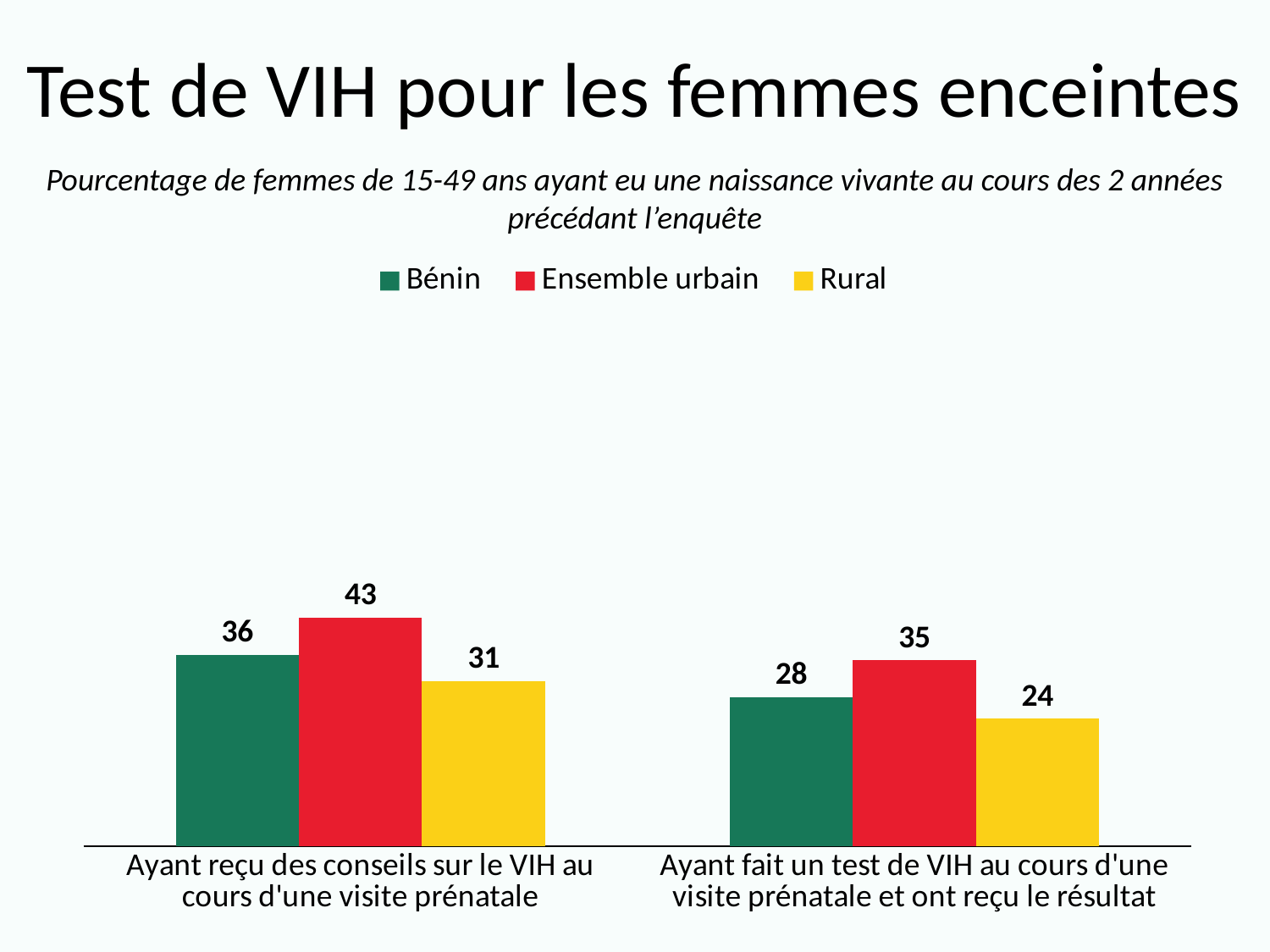
Which is larger: the Rural value for 'Ayant reçu des conseils sur le VIH' or the Bénin value for 'Ayant fait un test de VIH'? Rural value for 'Ayant reçu des conseils sur le VIH' (31) What is the value for Bénin in the category 'Ayant reçu des conseils sur le VIH au cours d'une visite prénatale'? 36 Which series has the highest value in the category 'Ayant reçu des conseils sur le VIH au cours d'une visite prénatale'? Ensemble urbain What kind of chart is shown on the slide? Bar chart Which colour represents the Rural series in the legend? Yellow How many series does the legend list? 3 How many categories are shown on the x axis? 2 What is the value for Ensemble urbain in the category 'Ayant fait un test de VIH au cours d'une visite prénatale et ont reçu le résultat'? 35 What is the difference between the Bénin values for the two categories? 8 What is the difference between the Ensemble urbain and Rural values in the category 'Ayant reçu des conseils sur le VIH au cours d'une visite prénatale'? 12 Which series has the lowest value in the category 'Ayant fait un test de VIH au cours d'une visite prénatale et ont reçu le résultat'? Rural What is the value for Rural in the category 'Ayant reçu des conseils sur le VIH au cours d'une visite prénatale'? 31